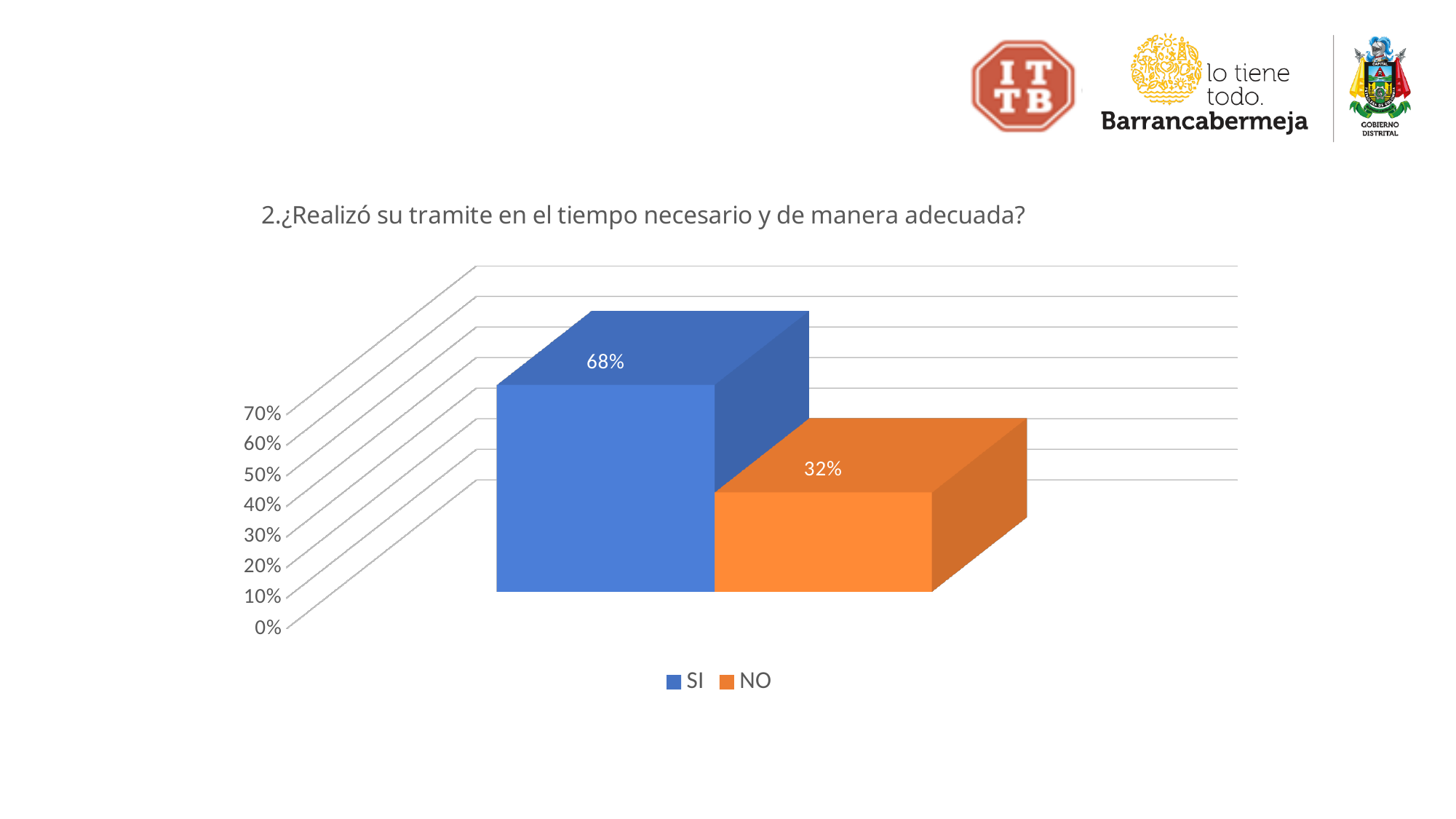
Is the value for SI greater or less than 50%? greater What is the title of the chart? 2.¿Realizó su tramite en el tiempo necesario y de manera adecuada? What is the value for NO? 32% Which is larger, the value for SI or the value for NO? SI Is the value for NO greater or less than 40%? less What colour is the bar for NO? orange Which series has the lowest value? NO How many series does the legend list? 2 What kind of chart is shown on the slide? bar chart Which series has the highest value? SI What is the value for SI? 68% What is the difference between the values for SI and NO? 36%